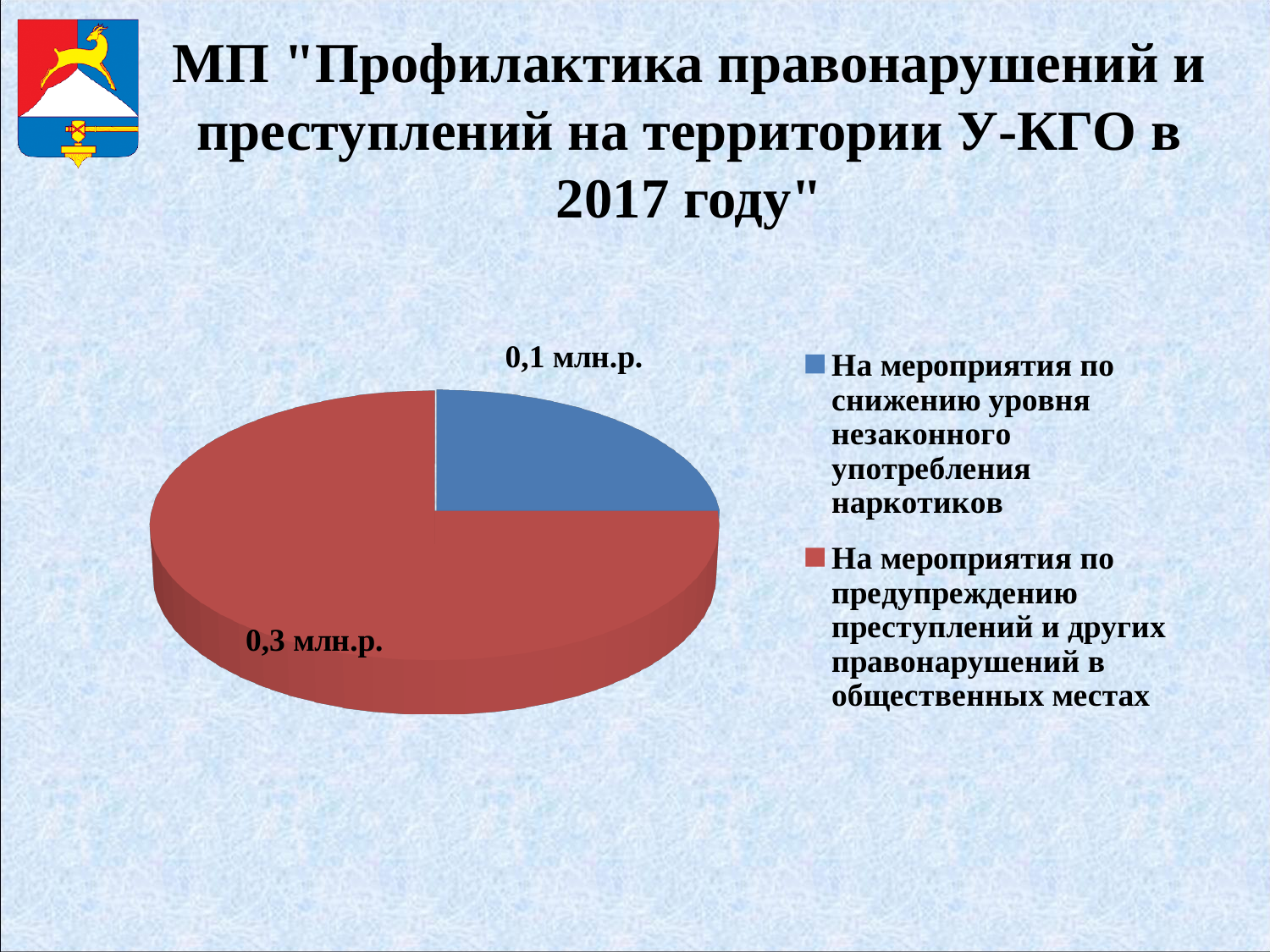
Which is larger: the value for reducing illegal drug use or the value for crime prevention in public places? На мероприятия по предупреждению преступлений и других правонарушений в общественных местах How many slices does the pie chart have? 2 What is the difference between the value for crime prevention in public places and the value for reducing illegal drug use? 0,2 млн.р. What is the total of the two slices shown in the pie chart? 0,4 млн.р. Which category has the smallest slice of the pie? На мероприятия по снижению уровня незаконного употребления наркотиков What kind of chart is shown on the slide? Pie chart What is the value for the slice 'На мероприятия по снижению уровня незаконного употребления наркотиков'? 0,1 млн.р. How many entries does the legend list? 2 What colour is the slice for 'На мероприятия по предупреждению преступлений и других правонарушений в общественных местах'? Red Which category has the largest slice of the pie? На мероприятия по предупреждению преступлений и других правонарушений в общественных местах What share of the pie does the slice 'На мероприятия по снижению уровня незаконного употребления наркотиков' represent? 25% What is the value for the slice 'На мероприятия по предупреждению преступлений и других правонарушений в общественных местах'? 0,3 млн.р.